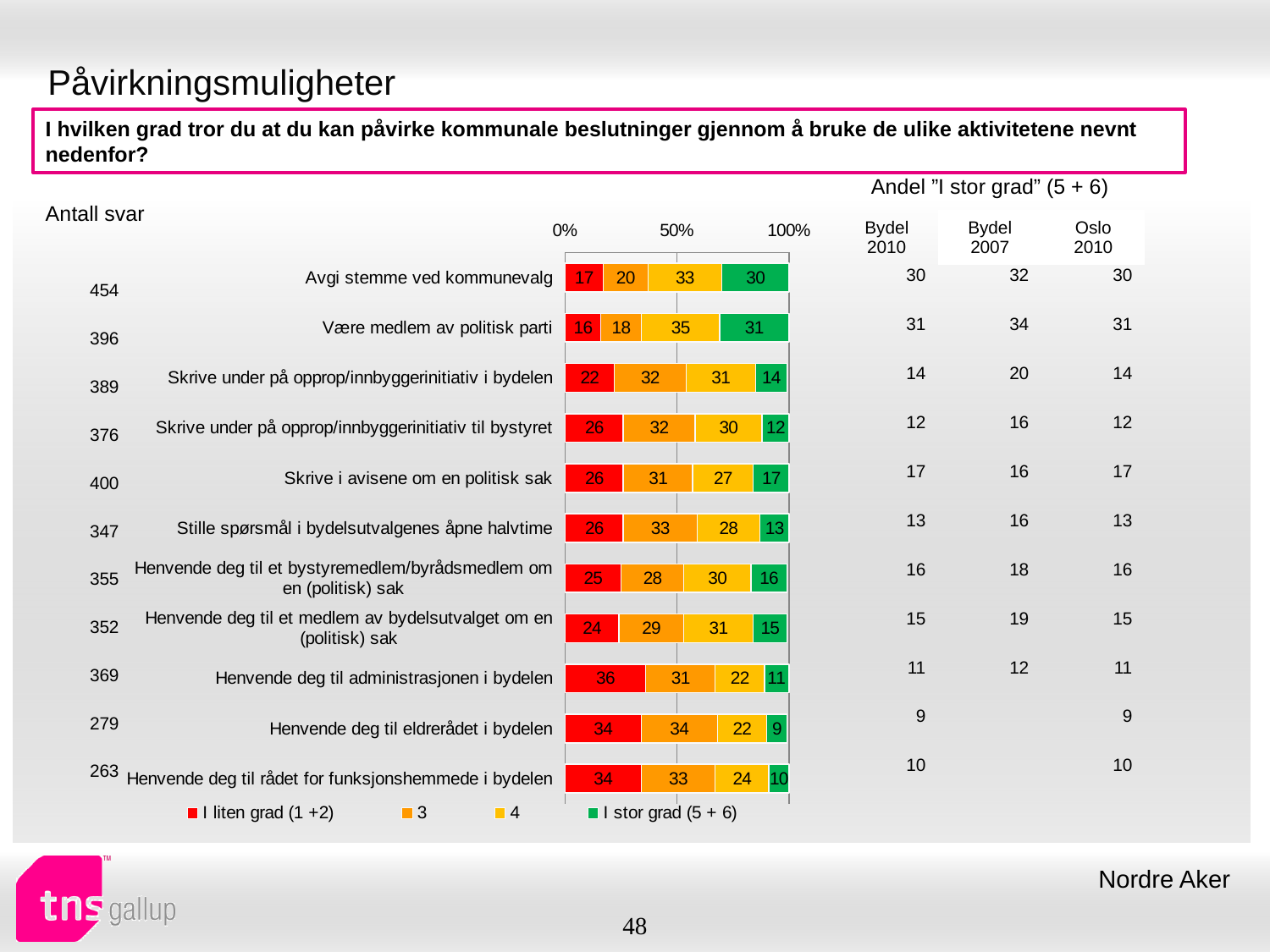
Which activity has the highest 'I stor grad (5 + 6)' value? Være medlem av politisk parti Which colour represents 'I stor grad (5 + 6)' in the chart? Green Which activity has the lowest 'I stor grad (5 + 6)' value? Henvende deg til eldrerådet i bydelen What is the value of 'I liten grad (1 +2)' for 'Henvende deg til administrasjonen i bydelen'? 36 How many categories (activities) are plotted in the chart? 11 What is the value of series '4' for 'Være medlem av politisk parti'? 35 What kind of chart is shown on the slide? Stacked bar chart What is the value of 'I stor grad (5 + 6)' for 'Avgi stemme ved kommunevalg'? 30 What is the total of the stacked bar for 'Henvende deg til eldrerådet i bydelen'? 99 Which is larger: the 'I liten grad (1 +2)' value for 'Skrive i avisene om en politisk sak' or for 'Avgi stemme ved kommunevalg'? Skrive i avisene om en politisk sak What is the difference between the 'I stor grad (5 + 6)' values for 'Være medlem av politisk parti' and 'Henvende deg til eldrerådet i bydelen'? 22 How many series does the chart legend list? 4